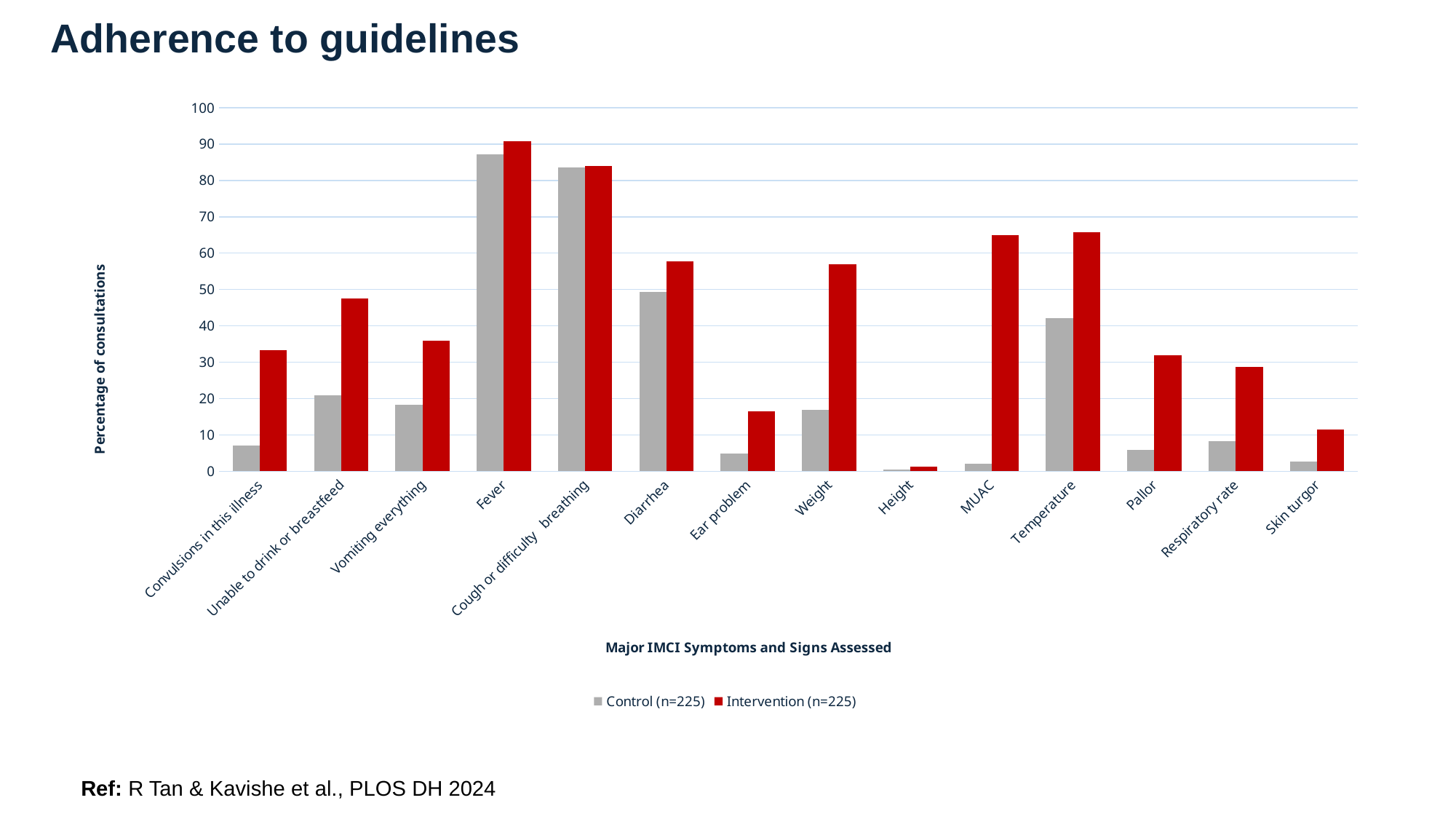
Is the Intervention (n=225) value for Weight greater or less than 50? greater Is the Intervention (n=225) value for MUAC greater or less than 60? greater Is the Control (n=225) value for Ear problem greater or less than 10? less What is the title of the y axis? Percentage of consultations How many symptom/sign categories are shown on the x axis? 14 Which category has the lowest Control (n=225) value? Height Which category has the highest Intervention (n=225) value? Fever How many series does the legend list? 2 What kind of chart is shown on the slide? bar chart For MUAC, which series has the larger value: Control (n=225) or Intervention (n=225)? Intervention (n=225) Which colour represents the Intervention (n=225) series? red